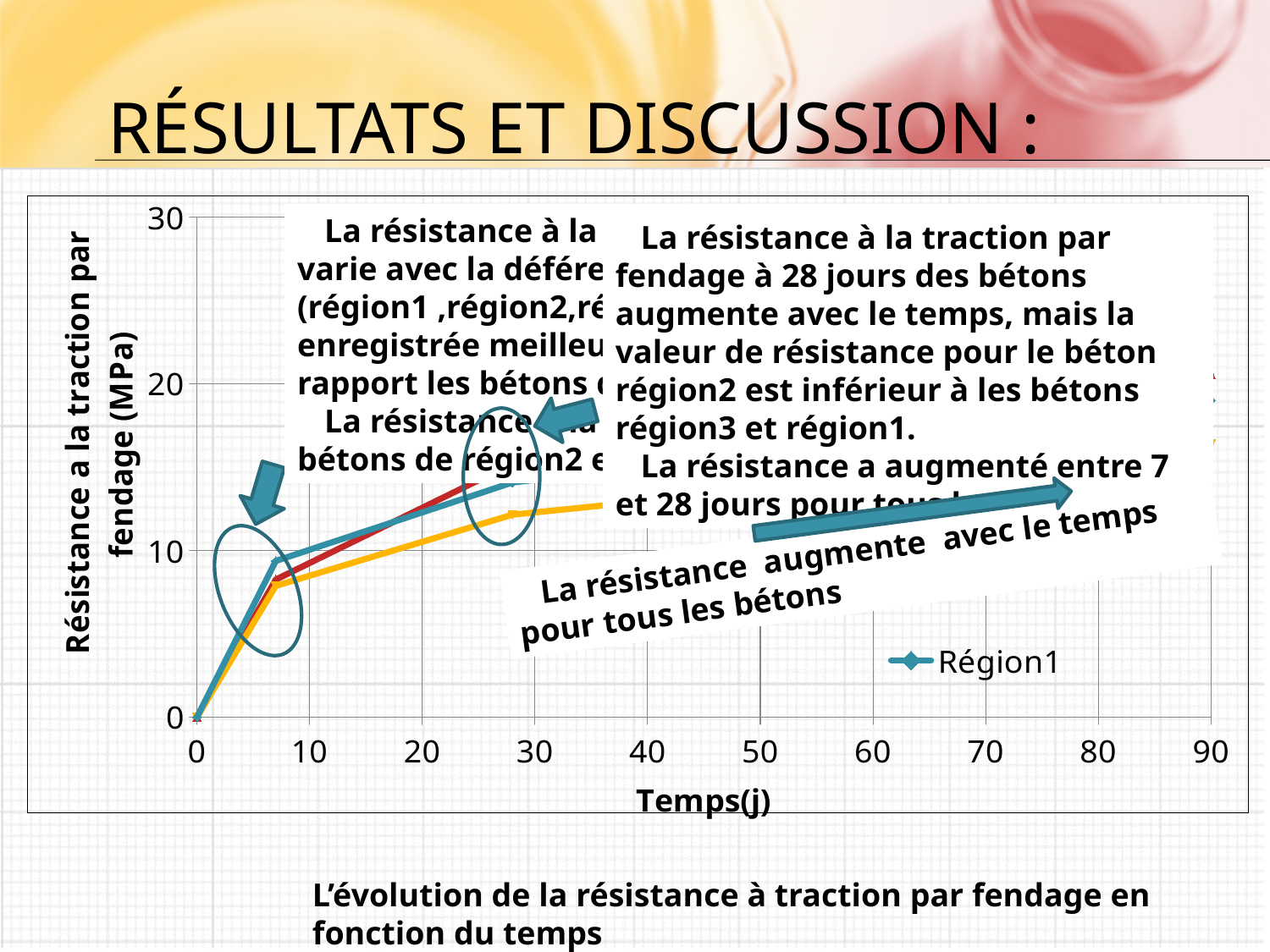
What is the value for Région1 at 0 days? 0 Is the value for Région1 at 7 days greater or less than 5? greater What is the title of the y axis of the chart? Résistance a la traction par fendage (MPa) Is the value for Région1 at 28 days greater or less than 20? less Which series name is readable in the chart legend? Région1 Do the plotted values rise or fall as time (Temps) increases along the x axis? rise What is the title of the x axis of the chart? Temps(j) Is the value for Région1 at 28 days greater or less than 10? greater What kind of chart is shown on the slide? line chart